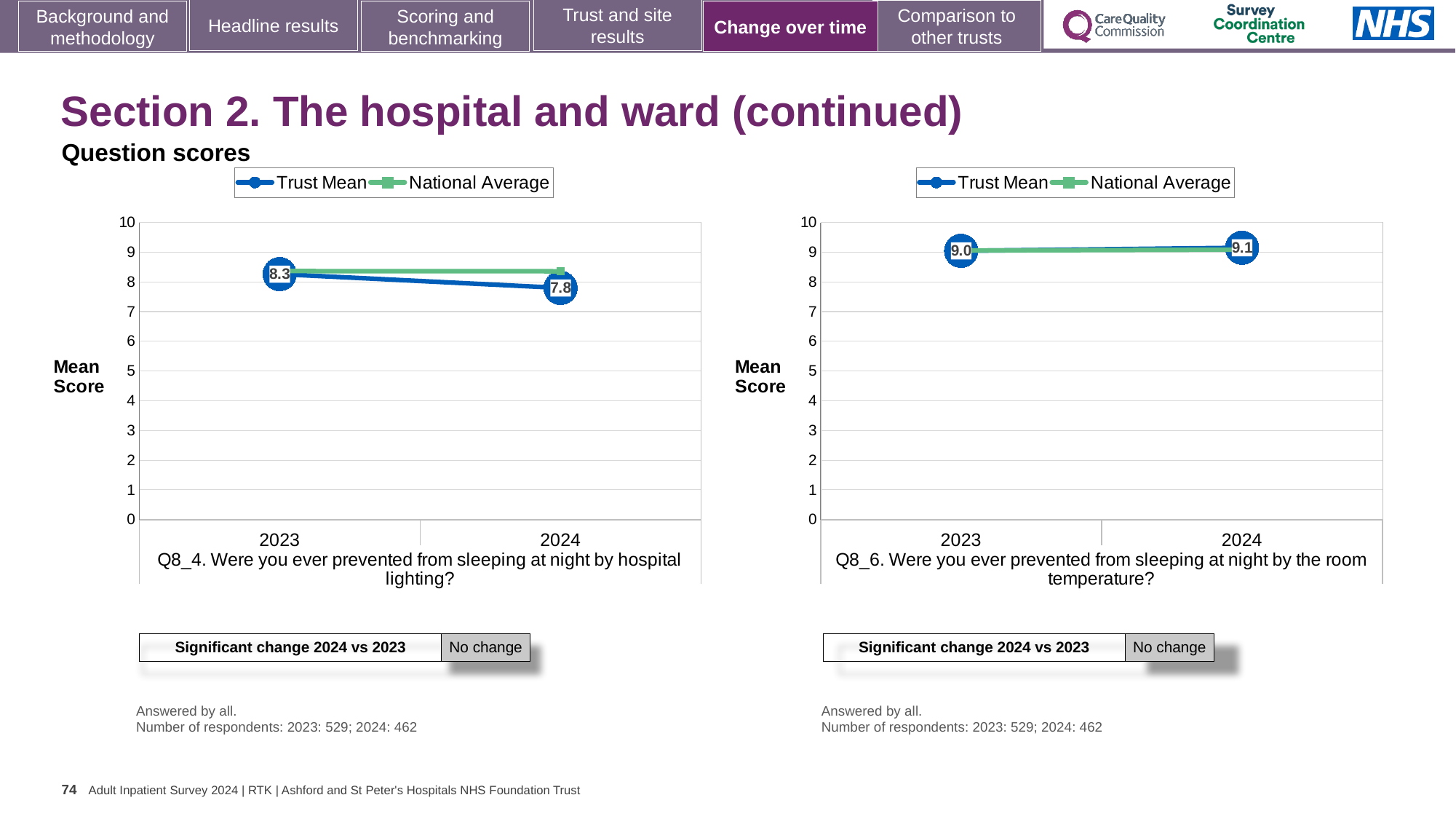
In the Q8_4 chart on the left, what is the Trust Mean score for 2024? 7.8 In the Q8_4 chart on the left, is the National Average for 2024 greater or less than 8? greater In the Q8_6 chart on the right, what is the Trust Mean score for 2023? 9.0 In the Q8_6 chart on the right, does the Trust Mean rise or fall from 2023 to 2024? rise In the Q8_4 chart on the left, by how much did the Trust Mean fall from 2023 to 2024? 0.5 In the Q8_4 chart on the left, which year has the higher Trust Mean score? 2023 How many series does the legend of the Q8_6 chart on the right list? 2 What type of chart is the Q8_4 chart on the left? line chart In the Q8_6 chart on the right, what is the Trust Mean score for 2024? 9.1 In the Q8_4 chart on the left, does the Trust Mean rise or fall from 2023 to 2024? fall In the Q8_4 chart on the left, what is the Trust Mean score for 2023? 8.3 In the Q8_4 chart on the left, for 2024, which is higher: the Trust Mean or the National Average? National Average